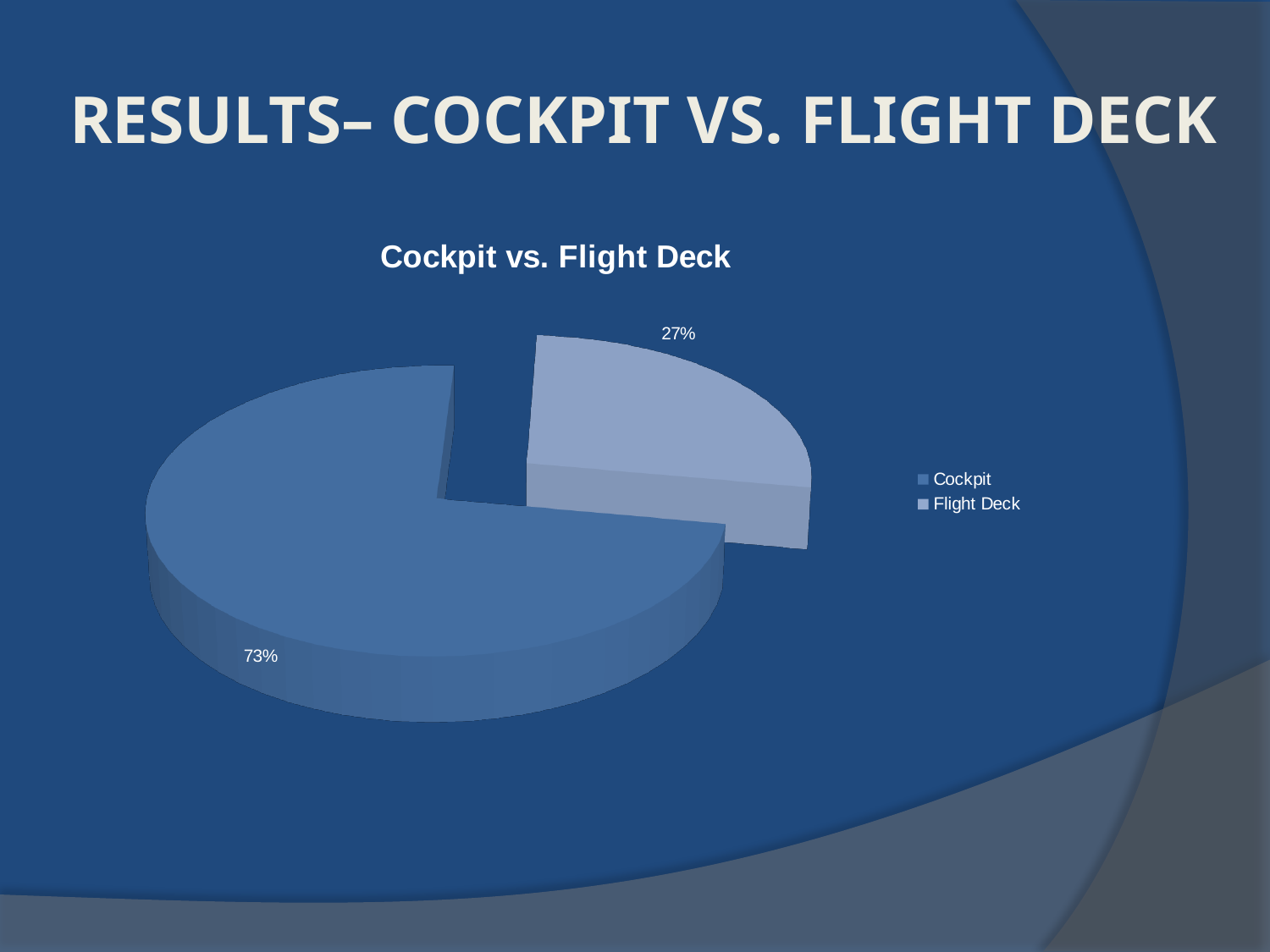
What is the difference in percentage points between the Cockpit and Flight Deck slices? 46 What kind of chart is shown on the slide? Pie chart What share of the pie is taken by the Flight Deck slice? 27% Which is larger, the Cockpit slice or the Flight Deck slice? Cockpit How many entries does the legend list? 2 Which category has the largest share of the pie? Cockpit What percentage of the pie does the Cockpit slice represent? 73% What is the title of the chart? Cockpit vs. Flight Deck What percentage of the pie does the Flight Deck slice represent? 27% How many slices does the pie chart have? 2 Which legend entry is listed first? Cockpit Which category has the smallest share of the pie? Flight Deck